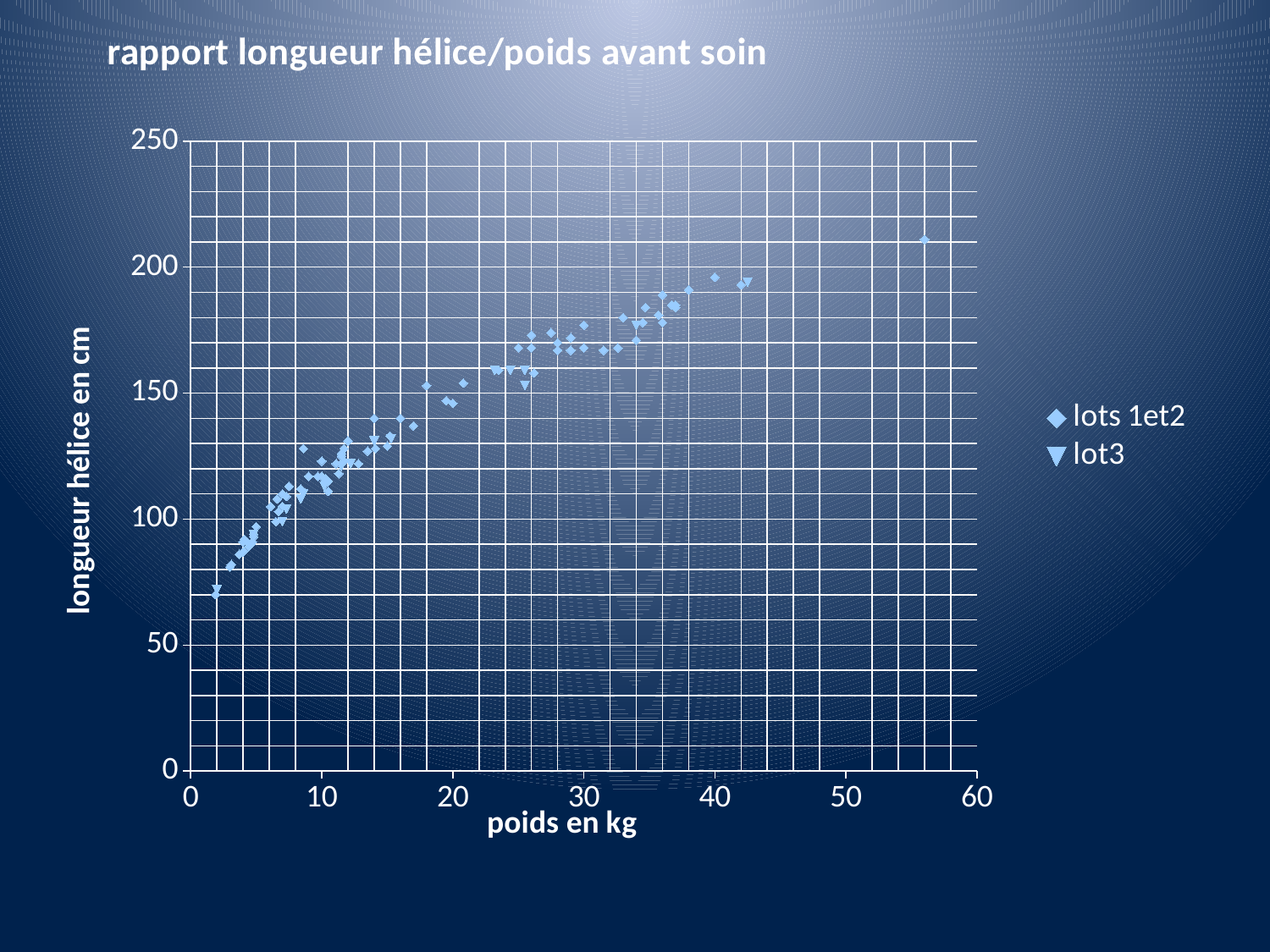
Is the longueur hélice value for the point with the highest poids (around 56 kg) greater or less than 200? greater What is the title of the chart? rapport longueur hélice/poids avant soin What is the label of the x axis? poids en kg Which series has the point with the highest poids on the chart, lots 1et2 or lot3? lots 1et2 Is the longueur hélice value for the points near 40 kg greater or less than 150? greater What kind of chart is shown on the slide? scatter chart Is the longueur hélice value for the point with the lowest poids (around 2 kg) greater or less than 100? less How many series does the legend list? 2 What is the maximum value shown on the y axis? 250 As the weight (poids) increases along the x axis, does the propeller length (longueur hélice) generally rise or fall? rise